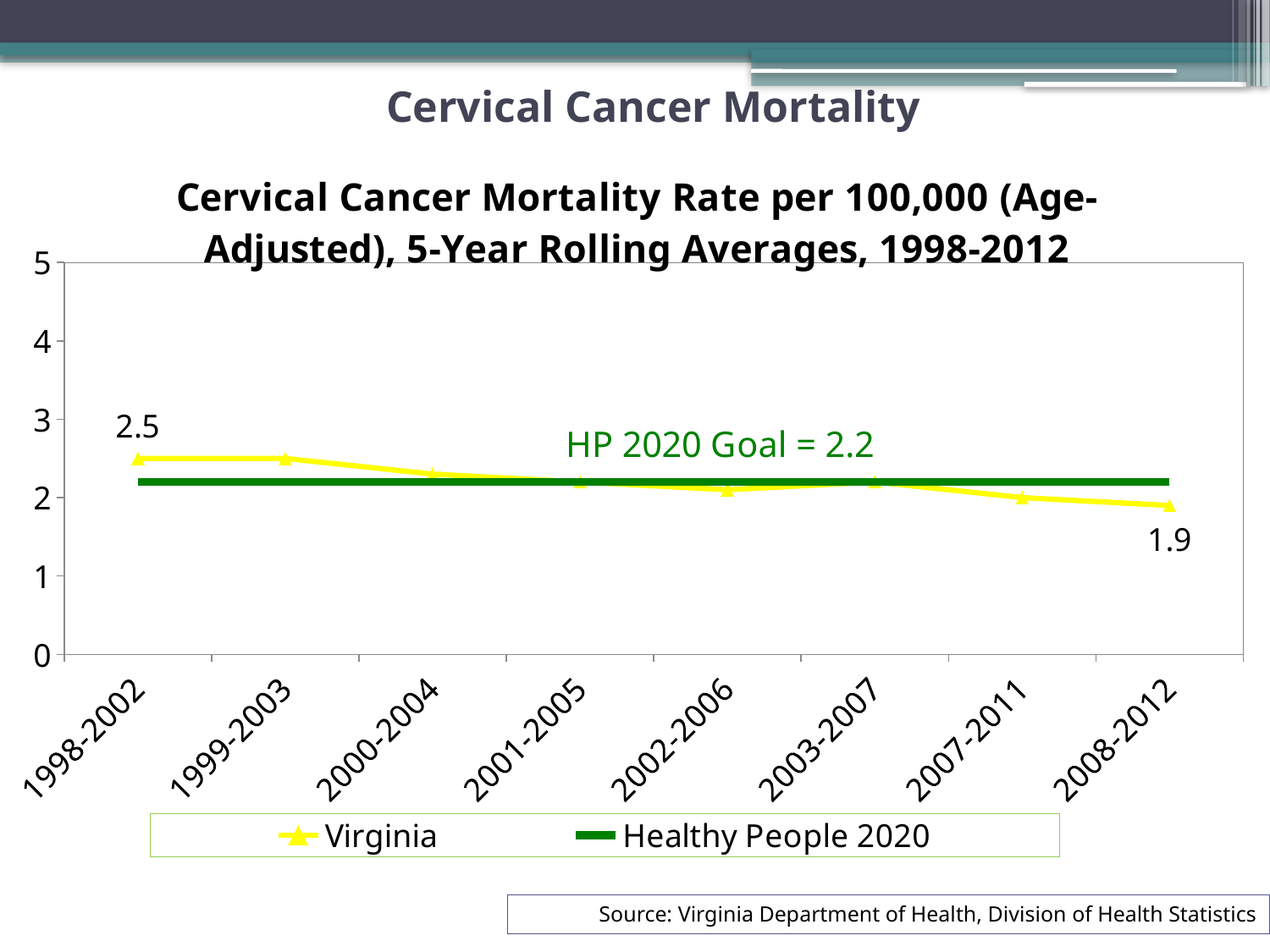
Which is larger, the Virginia rate for 1998-2002 or for 2008-2012? 1998-2002 Is the Virginia value for 2000-2004 greater or less than 3? less What is the difference between the Virginia rate for 1998-2002 and the rate for 2008-2012? 0.6 What is the Virginia cervical cancer mortality rate for 2008-2012? 1.9 Does the Virginia cervical cancer mortality rate rise or fall from 1998-2002 to 2008-2012? fall Is the Virginia value for 1998-2002 greater or less than 2? greater How many series does the legend list? 2 What kind of chart is shown on the slide? line chart How many time periods are shown on the x axis? 8 What is the Virginia cervical cancer mortality rate for 1998-2002? 2.5 What is the Healthy People 2020 goal value shown on the chart? 2.2 What are the two entries in the chart legend? Virginia and Healthy People 2020